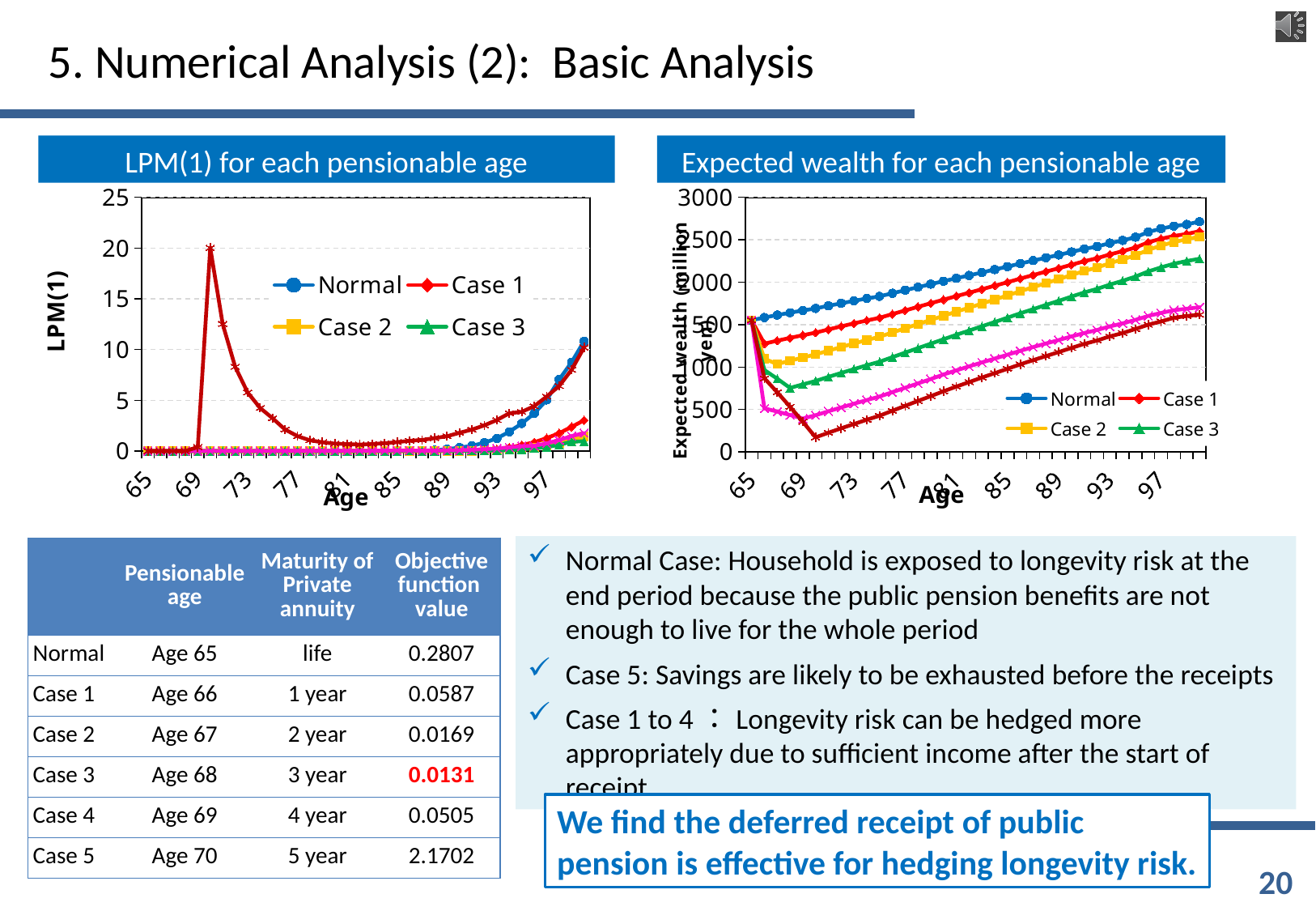
In the 'LPM(1) for each pensionable age' chart, is the value for Normal at age 89 greater or less than 5? less In the 'Expected wealth for each pensionable age' chart, which is larger at age 85, Normal or Case 3? Normal What is the label on the horizontal axis of the 'Expected wealth for each pensionable age' chart? Age In the 'Expected wealth for each pensionable age' chart, is the value for Case 1 at age 69 greater or less than 1000? greater What kind of chart is the 'Expected wealth for each pensionable age' chart? line chart How many series does the legend of the 'Expected wealth for each pensionable age' chart list? 4 What kind of chart is the 'LPM(1) for each pensionable age' chart? line chart In the 'Expected wealth for each pensionable age' chart, does the Normal series rise or fall as age increases from 65 to the end of the axis? rise What is the label on the vertical axis of the 'LPM(1) for each pensionable age' chart? LPM(1) In the 'Expected wealth for each pensionable age' chart, is the value for Case 3 at age 69 greater or less than 1000? less How many series does the legend of the 'LPM(1) for each pensionable age' chart list? 4